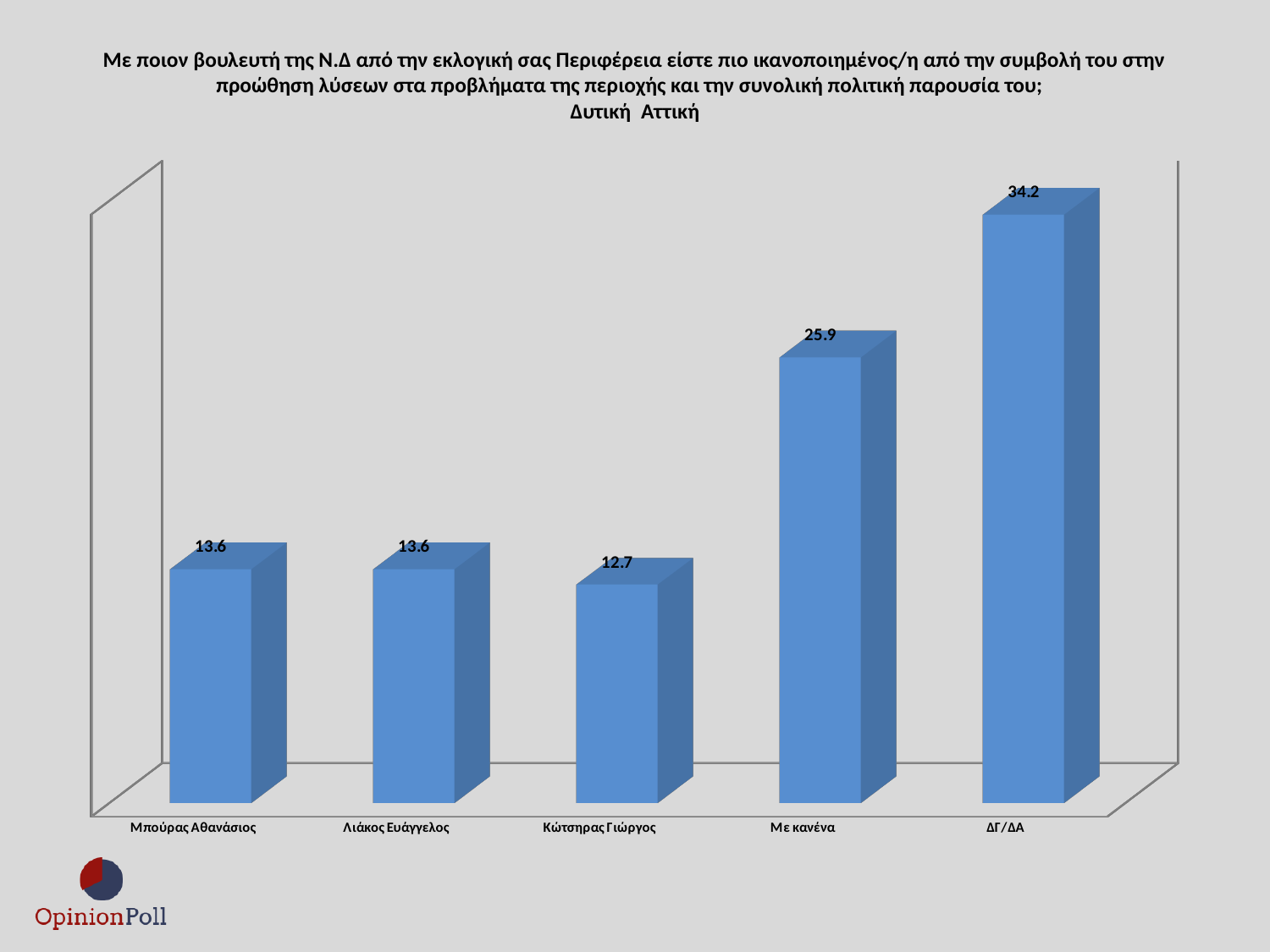
Which category has the lowest value? Κώτσηρας Γιώργος Which is larger, the value for Με κανένα or the value for Λιάκος Ευάγγελος? Με κανένα Which region is named in the chart title? Δυτική Αττική What is the value for ΔΓ/ΔΑ? 34.2 What kind of chart is shown on the slide? Bar chart What is the value for Κώτσηρας Γιώργος? 12.7 How many categories are shown on the x axis? 5 What is the difference between the values for ΔΓ/ΔΑ and Με κανένα? 8.3 What is the difference between the values for Μπούρας Αθανάσιος and Κώτσηρας Γιώργος? 0.9 What is the value for Με κανένα? 25.9 What is the value for Μπούρας Αθανάσιος? 13.6 Which category has the highest value? ΔΓ/ΔΑ